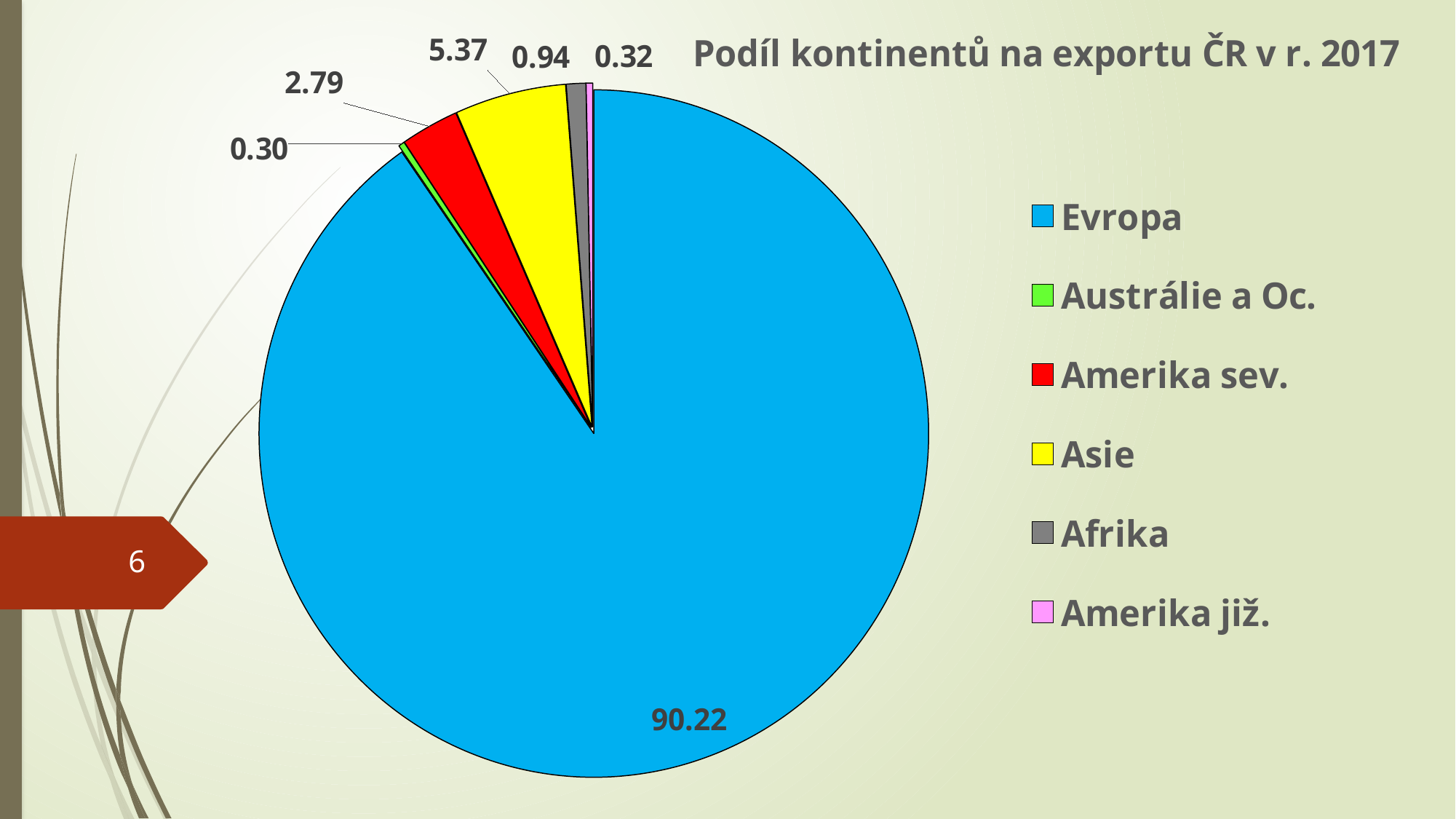
What is the difference between the values for Asie and Amerika sev.? 2.58 Which is larger, the value for Asie or the value for Amerika sev.? Asie Which continent has the smallest share of the pie? Austrálie a Oc. What is the value shown for Asie? 5.37 What is the value shown for Evropa? 90.22 What is the title of the chart? Podíl kontinentů na exportu ČR v r. 2017 How many slices does the pie chart have? 6 What is the value shown for Amerika sev.? 2.79 Which continent has the largest share of the pie? Evropa What type of chart is shown on the slide? pie chart What is the value shown for Amerika již.? 0.32 What is the value shown for Afrika? 0.94